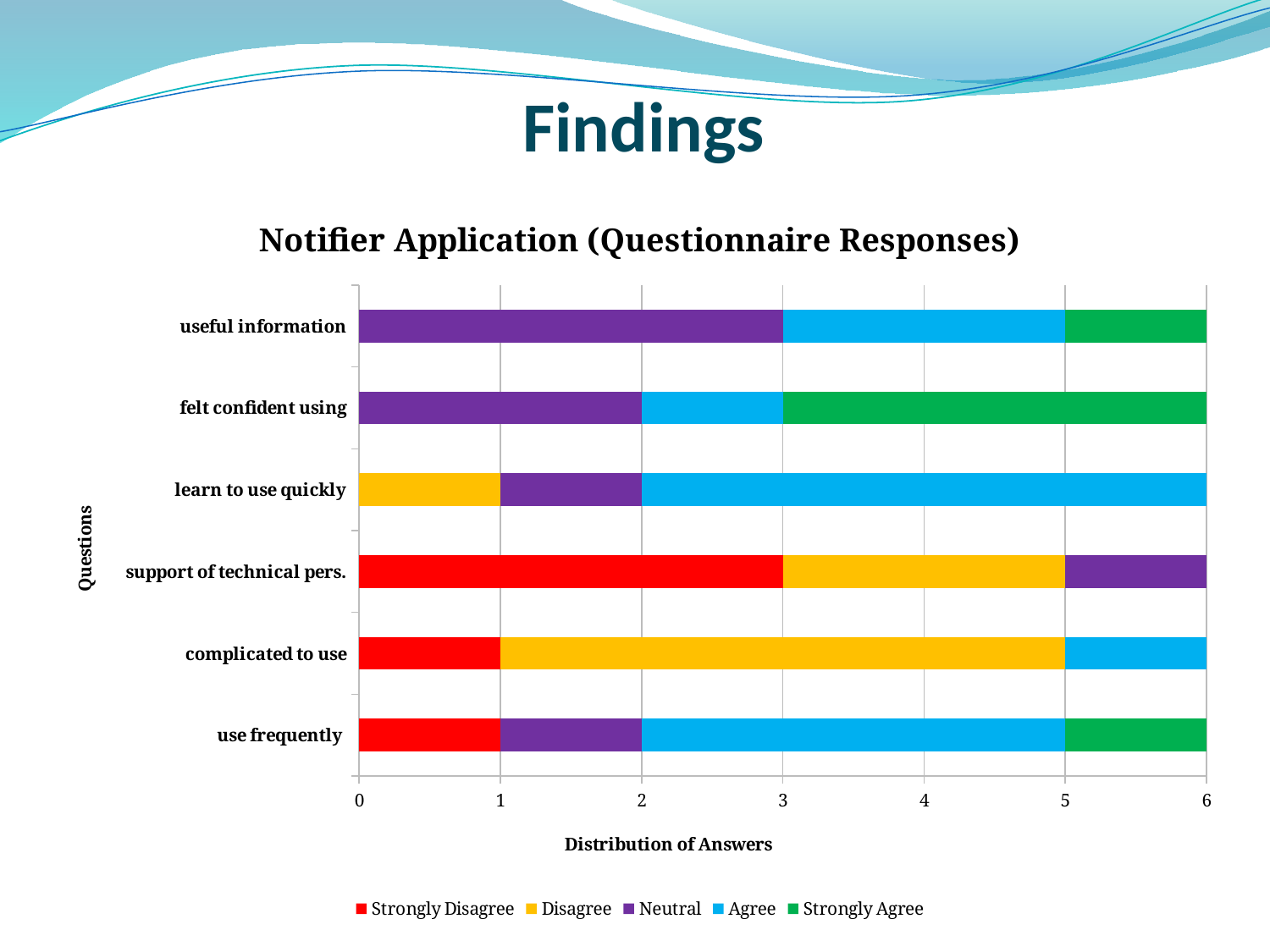
What is the difference between the 'Neutral' responses for 'useful information' and for 'felt confident using'? 1 What is the total number of responses for the 'useful information' bar? 6 Which question has the most 'Strongly Agree' responses? felt confident using How many series does the legend list? 5 What kind of chart is shown on the slide? Stacked bar chart How many 'Strongly Disagree' responses are there for 'support of technical pers.'? 3 What is the label of the horizontal axis? Distribution of Answers How many 'Strongly Agree' responses are there for 'felt confident using'? 3 How many 'Disagree' responses are there for 'complicated to use'? 4 What is the title of the chart? Notifier Application (Questionnaire Responses) How many questions (categories) are shown on the chart? 6 How many 'Agree' responses are there for 'learn to use quickly'? 4